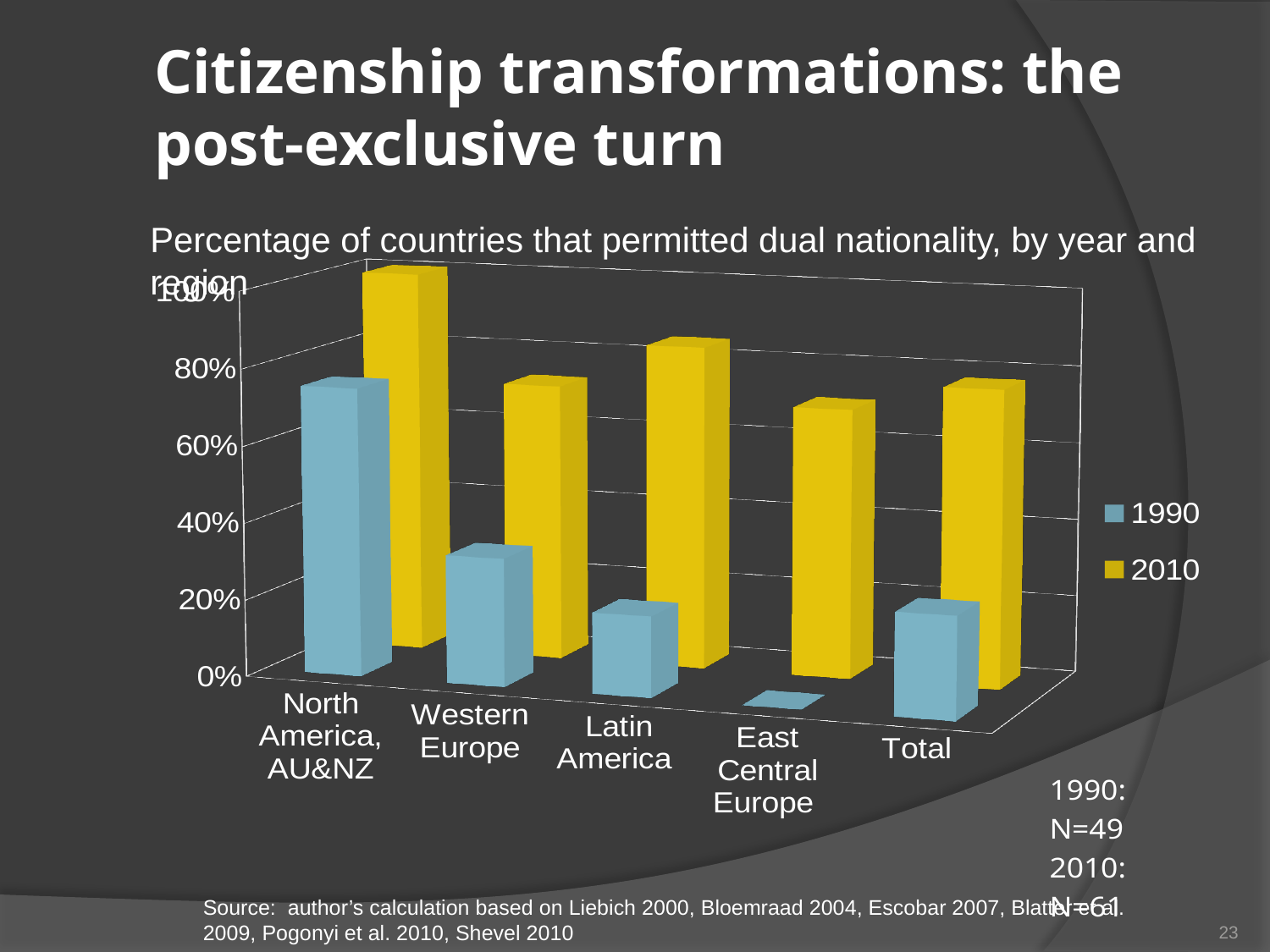
How many regional categories are shown on the x axis of the chart? 5 Which category has the lowest value for the 1990 series? East Central Europe Which category has the highest value for the 2010 series? North America, AU&NZ Is the 2010 value for East Central Europe greater or less than 40%? greater What are the two series names shown in the chart legend? 1990 and 2010 Which category has the highest value for the 1990 series? North America, AU&NZ Is the 2010 value for Latin America greater or less than 60%? greater How many series does the chart legend list? 2 Is the 1990 value for North America, AU&NZ greater or less than 60%? greater What kind of chart is shown on the slide? bar chart For Western Europe, which series has the larger value, 1990 or 2010? 2010